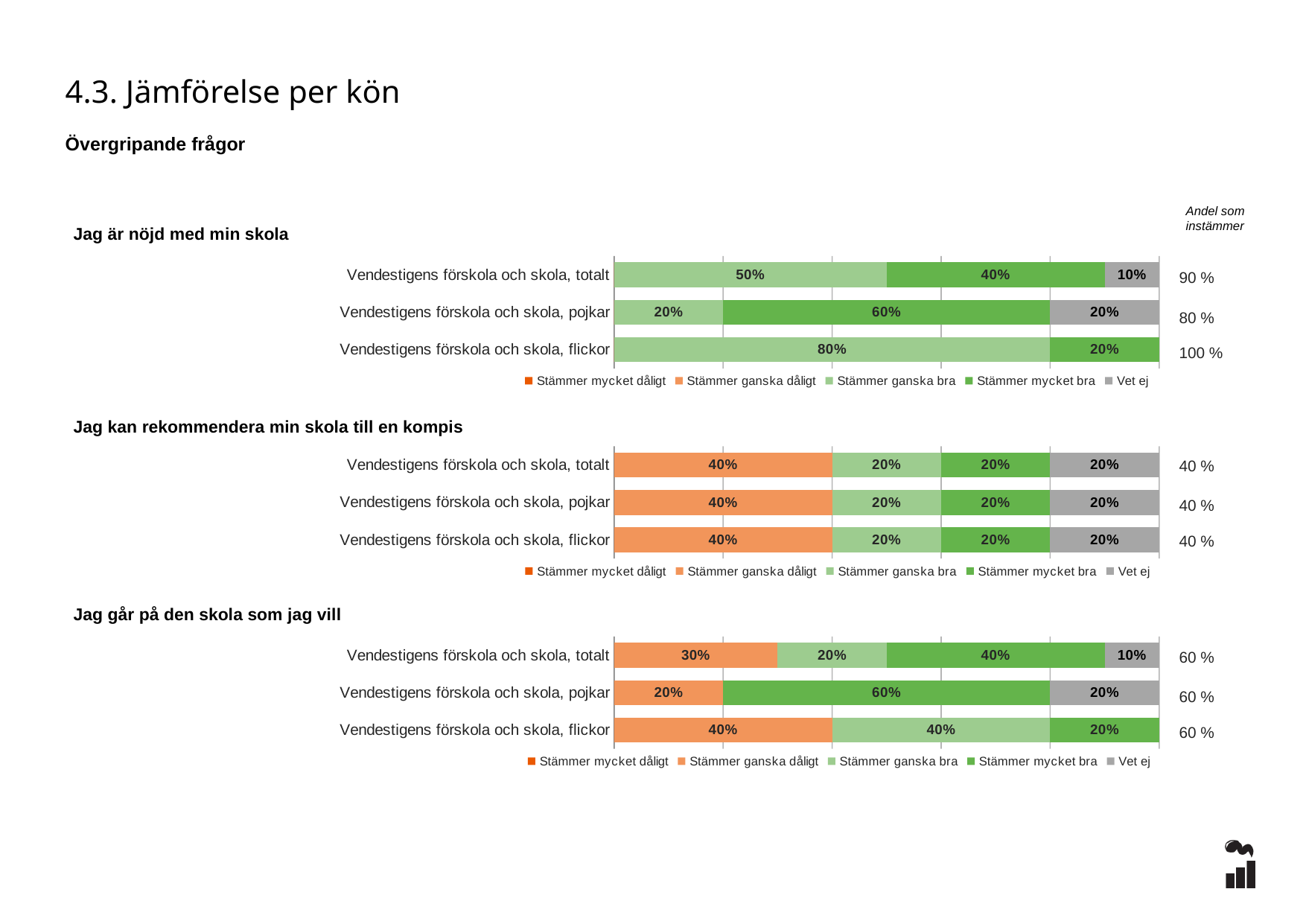
In the chart 'Jag är nöjd med min skola', what is the value of 'Stämmer ganska bra' for 'Vendestigens förskola och skola, flickor'? 80% In the chart 'Jag är nöjd med min skola', what is the 'Vet ej' value for 'Vendestigens förskola och skola, totalt'? 10% How many series does the legend of the chart 'Jag är nöjd med min skola' list? 5 What type of chart is 'Jag kan rekommendera min skola till en kompis'? Stacked bar chart In the chart 'Jag kan rekommendera min skola till en kompis', how many categories (bars) are shown? 3 In the chart 'Jag är nöjd med min skola', what is the value of 'Stämmer mycket bra' for 'Vendestigens förskola och skola, pojkar'? 60% In the chart 'Jag går på den skola som jag vill', what is the difference between the 'Stämmer mycket bra' values for 'pojkar' and 'flickor'? 40% In the chart 'Jag går på den skola som jag vill', which is larger for 'Vendestigens förskola och skola, flickor': 'Stämmer ganska dåligt' or 'Stämmer mycket bra'? Stämmer ganska dåligt In the chart 'Jag går på den skola som jag vill', what is the value of 'Stämmer ganska dåligt' for 'Vendestigens förskola och skola, totalt'? 30% In the chart 'Jag går på den skola som jag vill', which category has the lowest 'Stämmer mycket bra' value? Vendestigens förskola och skola, flickor In the chart 'Jag kan rekommendera min skola till en kompis', what is the value of 'Stämmer ganska dåligt' for 'Vendestigens förskola och skola, totalt'? 40% In the chart 'Jag är nöjd med min skola', which category has the highest 'Stämmer ganska bra' value? Vendestigens förskola och skola, flickor